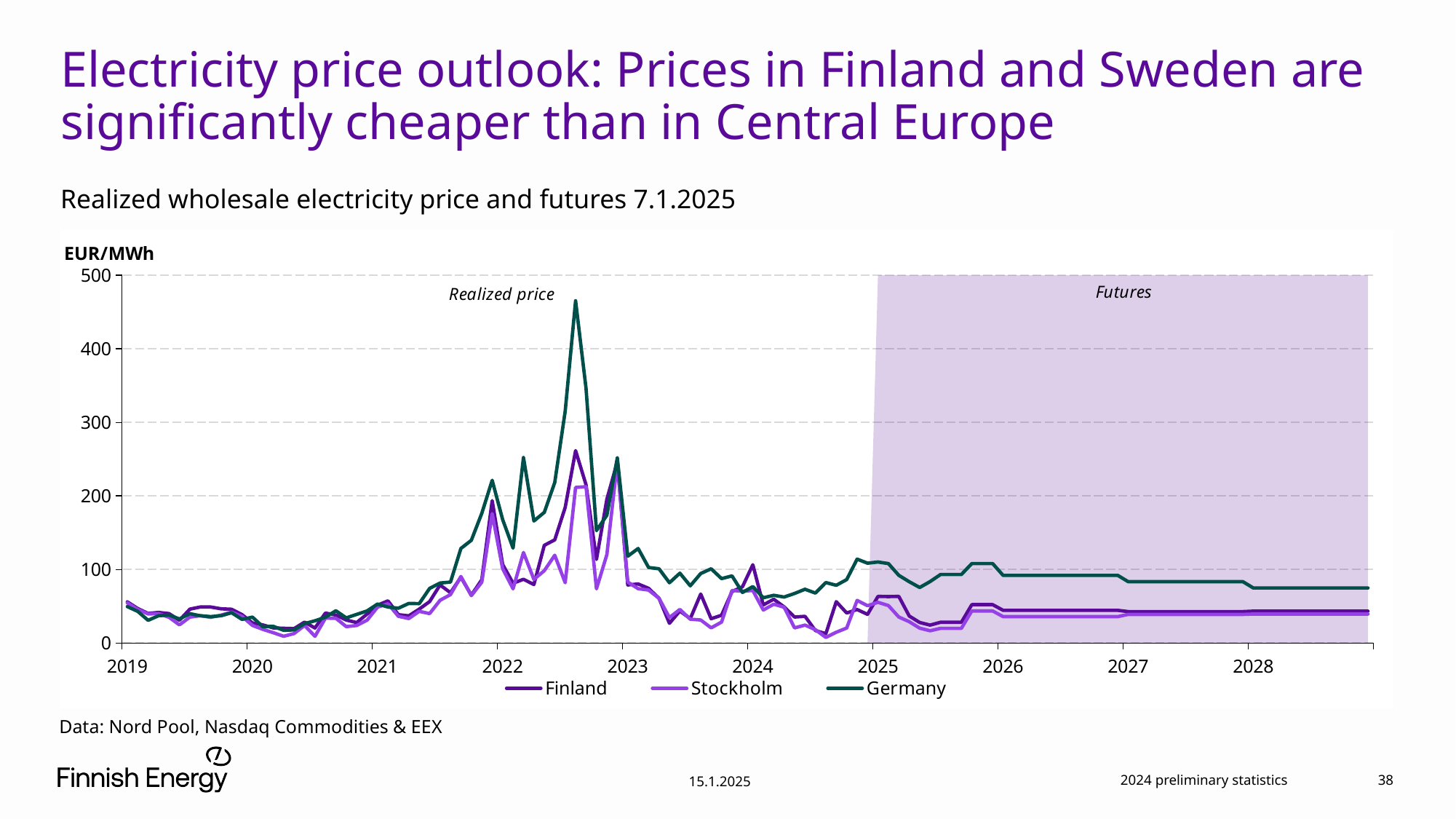
What unit is shown on the y axis of the chart? EUR/MWh Which series reaches the highest peak in the chart? Germany Is the futures value for Finland in 2028 greater or less than 100? less Is the peak value for Finland in 2022 greater or less than 300? less What kind of chart is shown on the slide? line chart How many series does the legend list? 3 Is the peak value for Germany in 2022 greater or less than 400? greater Do the Germany futures values rise or fall from 2026 to 2028? fall In the futures period for 2028, which is higher, Germany or Finland? Germany How many years are labeled on the x axis? 10 Which series are listed in the chart legend? Finland, Stockholm, Germany